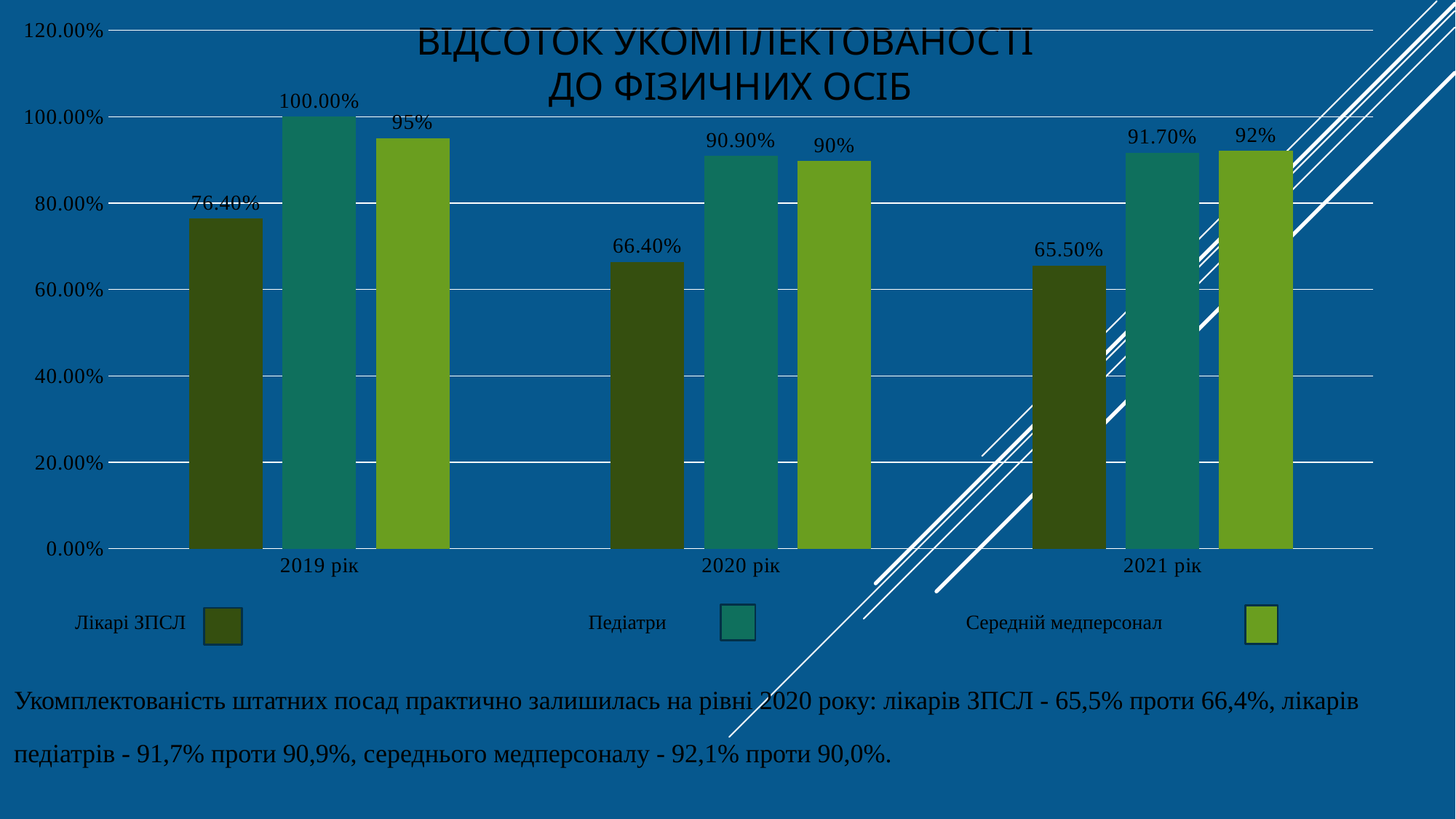
What is the value for Педіатри in 2020 рік? 90.90% Which series has the lowest value in 2021 рік? Лікарі ЗПСЛ What kind of chart is shown on the slide? Bar chart Which year has the highest value for Лікарі ЗПСЛ? 2019 рік How many year categories are shown on the x axis? 3 What is the value for Педіатри in 2019 рік? 100.00% How many series does the legend list? 3 What is the value for Лікарі ЗПСЛ in 2019 рік? 76.40% What is the difference between the Педіатри values in 2019 рік and 2020 рік? 9.10% Which is larger in 2020 рік: Педіатри or Середній медперсонал? Педіатри Do the values for Лікарі ЗПСЛ rise or fall from 2019 рік to 2021 рік? Fall What is the value for Середній медперсонал in 2021 рік? 92%